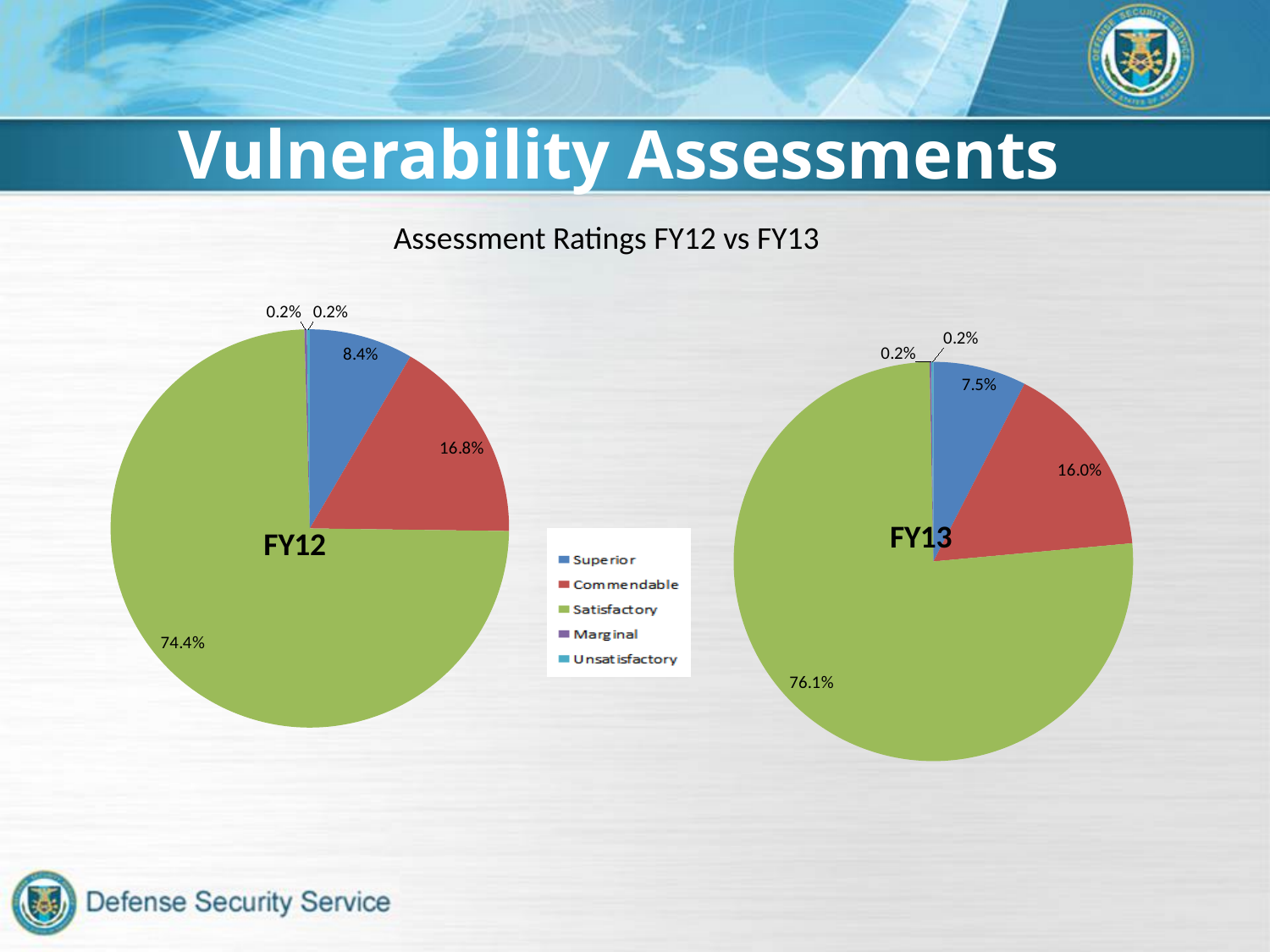
In the FY12 pie chart, what percentage is shown for the Commendable slice? 16.8% How many rating categories does the legend list? 5 Which is larger: the Commendable share in the FY12 pie chart or in the FY13 pie chart? FY12 What is the difference between the Superior share in FY12 (8.4%) and in FY13 (7.5%)? 0.9% In the FY13 pie chart, what share is labelled for the Satisfactory slice? 76.1% In the FY12 pie chart, what share is labelled for the Satisfactory slice? 74.4% What is the title shown above the two pie charts? Assessment Ratings FY12 vs FY13 What type of chart is used to show the FY12 and FY13 assessment ratings? Pie chart In the FY13 pie chart, what percentage is shown for the Commendable slice? 16.0% In the FY13 pie chart, what percentage is shown for the Superior slice? 7.5% In the FY13 pie chart, which rating category has the largest slice? Satisfactory In the FY12 pie chart, which rating category has the largest slice? Satisfactory